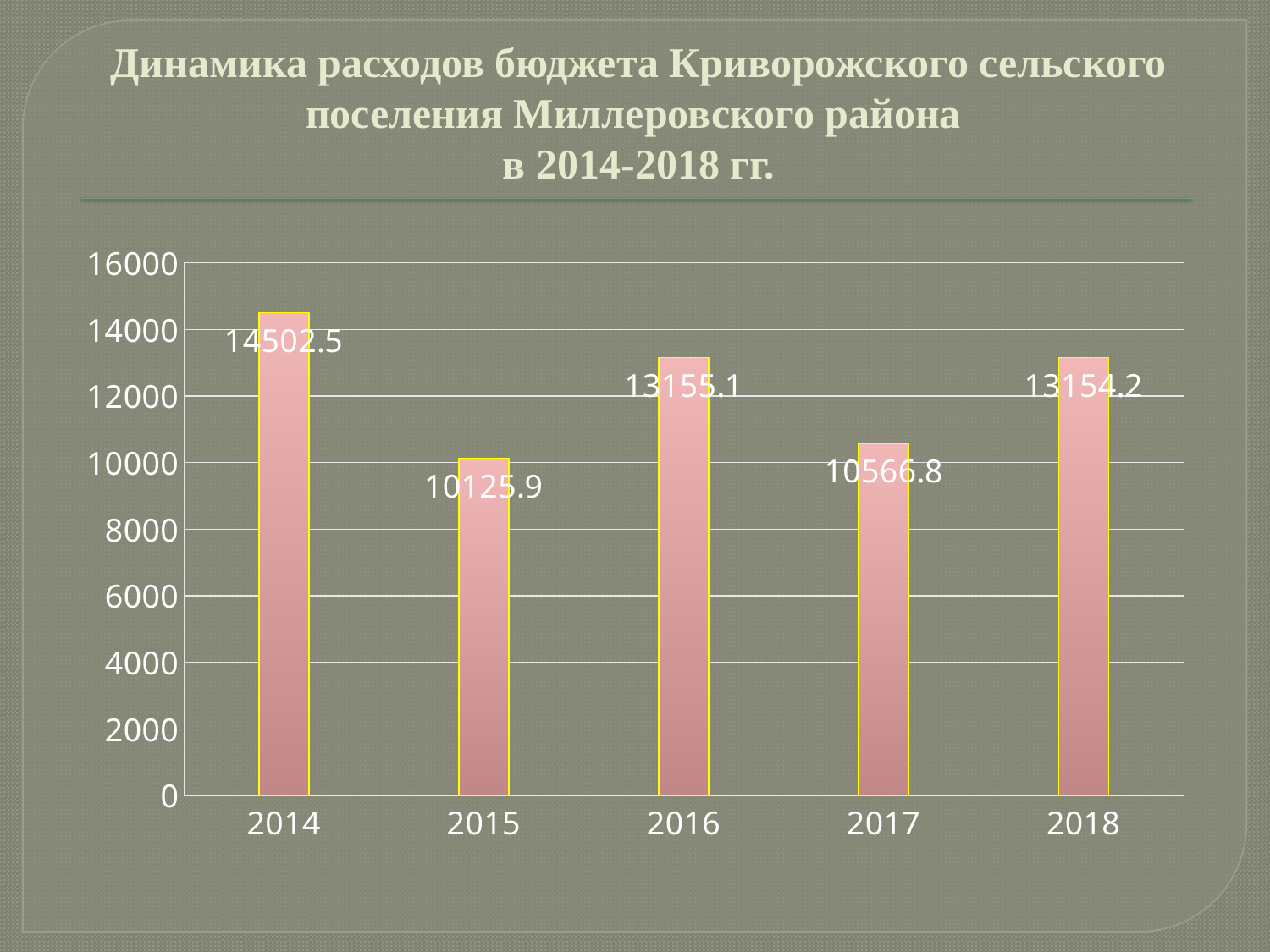
What is the value for 2015? 10125.9 What is the difference between the values for 2014 and 2015? 4376.6 Which is larger, the value for 2016 or the value for 2017? 2016 What is the difference between the values for 2016 and 2017? 2588.3 What is the value for 2014? 14502.5 Which year has the lowest value? 2015 Is the value for 2017 greater or less than 12000? less What is the value for 2017? 10566.8 Which year has the highest value? 2014 How many years are shown on the x axis? 5 What is the value for 2018? 13154.2 What kind of chart is shown on the slide? bar chart